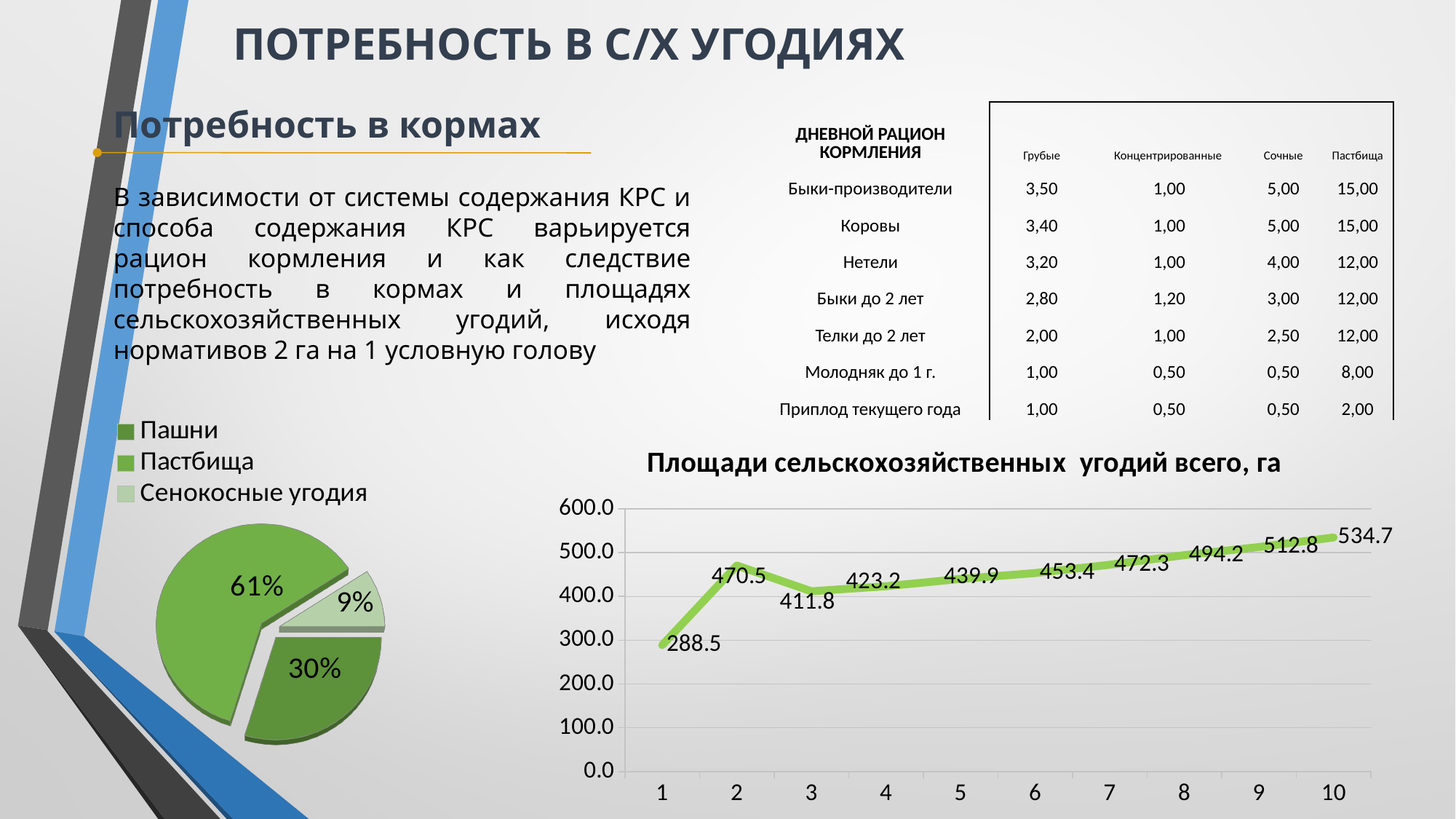
In the line chart 'Площади сельскохозяйственных угодий всего, га', what is the difference between the values at point 2 and point 3? 58.7 In the line chart 'Площади сельскохозяйственных угодий всего, га', what is the difference between the values at point 10 and point 1? 246.2 In the line chart 'Площади сельскохозяйственных угодий всего, га', what is the value at point 1? 288.5 In the pie chart on the left, what share does 'Сенокосные угодия' have? 9% In the pie chart on the left, what is the share of the largest slice? 61% In the line chart 'Площади сельскохозяйственных угодий всего, га', which point has the highest value? 10 What kind of chart is 'Площади сельскохозяйственных угодий всего, га'? line chart In the line chart 'Площади сельскохозяйственных угодий всего, га', do the values rise or fall from point 3 to point 10? rise In the line chart 'Площади сельскохозяйственных угодий всего, га', how many data points are plotted? 10 In the line chart 'Площади сельскохозяйственных угодий всего, га', which is larger: the value at point 2 or the value at point 7? point 7 In the line chart 'Площади сельскохозяйственных угодий всего, га', which point has the lowest value? 1 In the line chart 'Площади сельскохозяйственных угодий всего, га', what is the value at point 6? 453.4